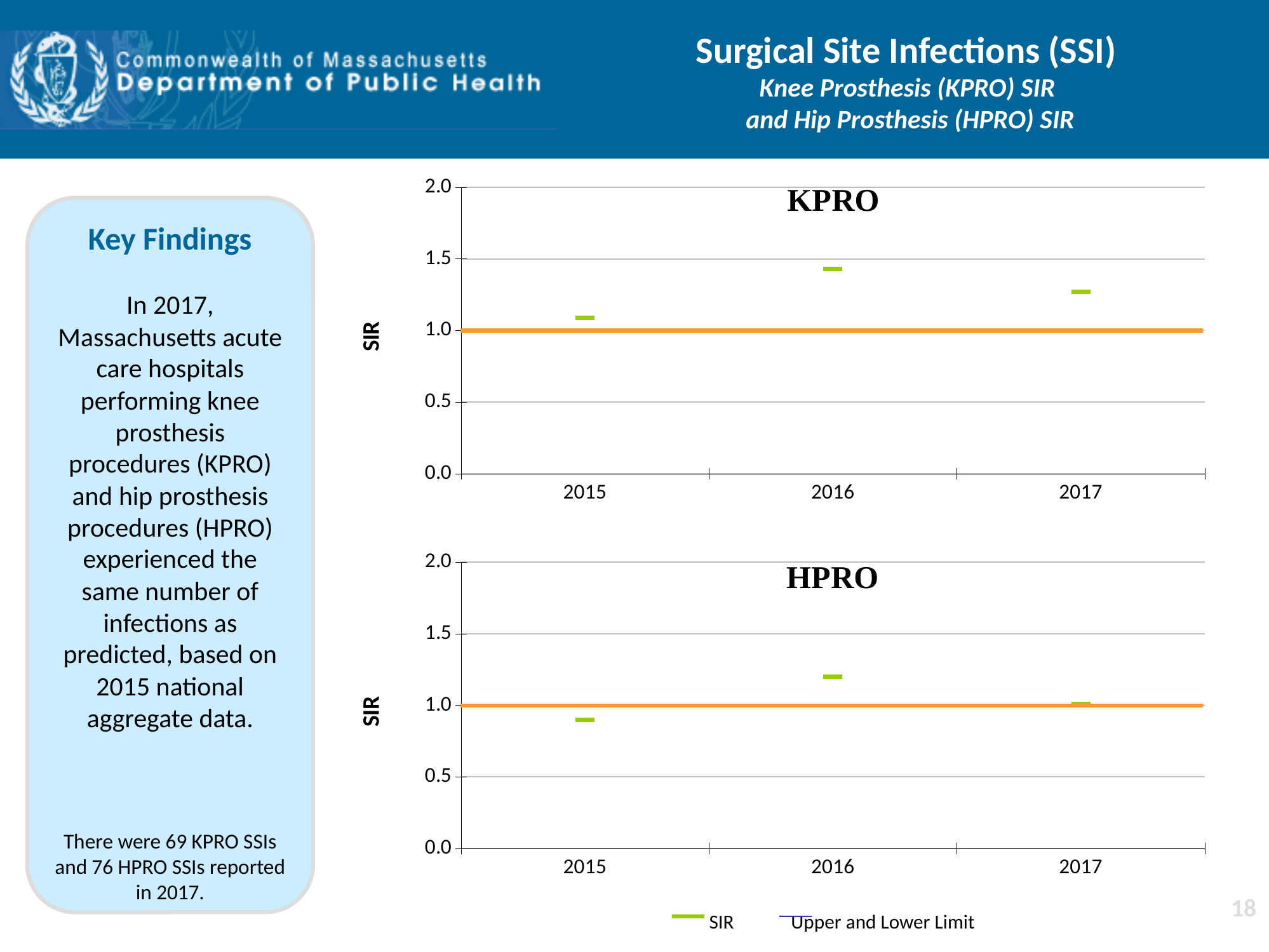
In the HPRO chart, is the SIR value for 2016 greater or less than 1.0? greater In the HPRO chart, which year has the highest SIR? 2016 What does the orange horizontal line in the charts represent, according to the legend? Upper and Lower Limit How many series does the legend below the charts list? 2 In the KPRO chart, which year has the lowest SIR? 2015 In the KPRO chart, is the SIR value for 2016 greater or less than 1.0? greater In the HPRO chart, which year has the lowest SIR? 2015 In the KPRO chart, is the SIR value for 2016 greater or less than 1.5? less In the KPRO chart, which year has the highest SIR? 2016 In the HPRO chart, how many years are plotted on the x axis? 3 In the KPRO chart, is the SIR higher in 2016 or 2017? 2016